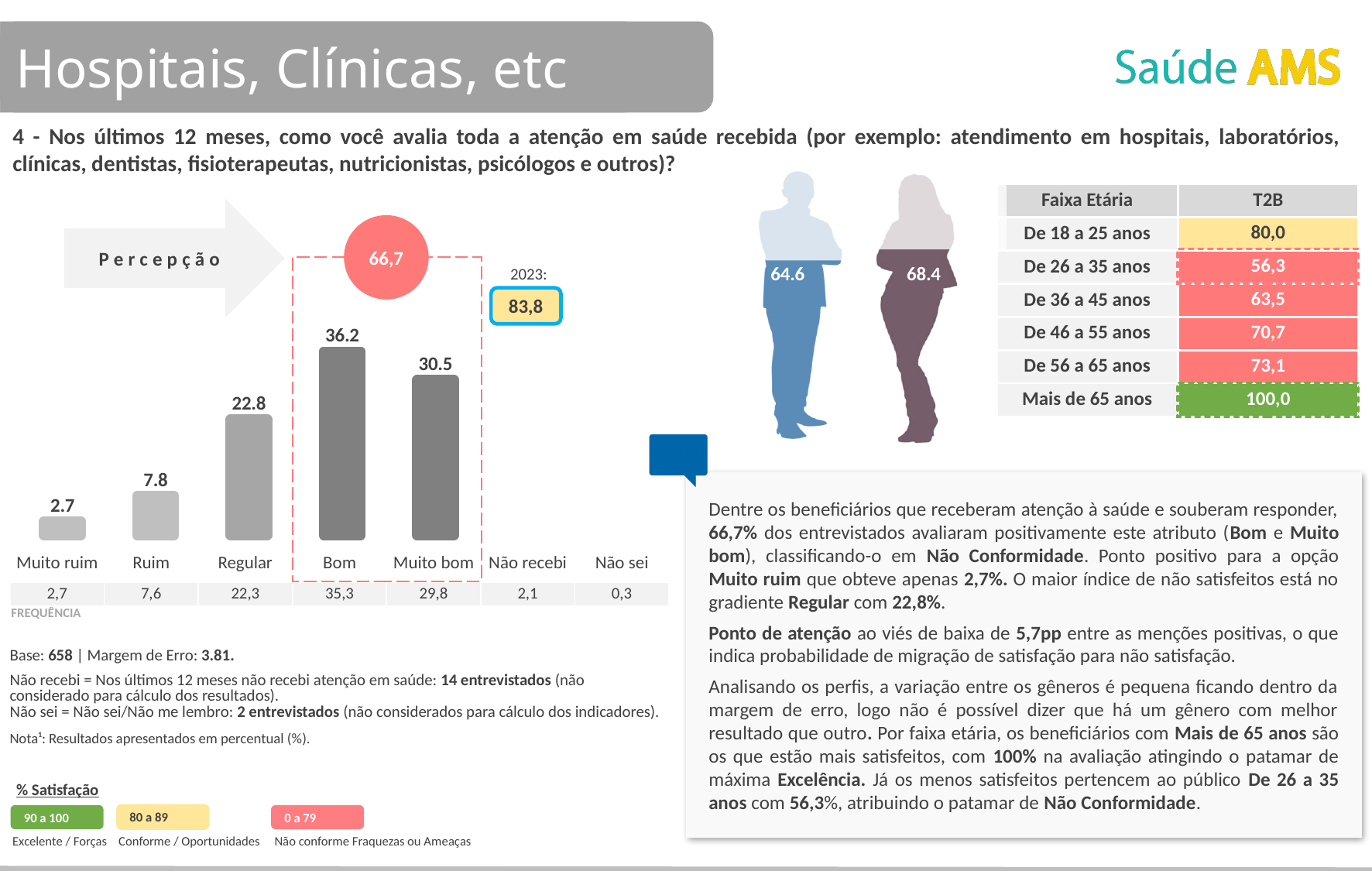
What type of chart is used to show the evaluation categories (Muito ruim to Muito bom)? bar chart What value is shown in the red circle above the Bom and Muito bom bars? 66,7 What is the value shown for the Muito ruim bar in the bar chart? 2.7 Which category has the highest bar in the bar chart? Bom Which bar is taller in the bar chart, Ruim or Regular? Regular Which category has the lowest bar in the bar chart? Muito ruim What is the value shown for the Bom bar in the bar chart? 36.2 How many bars are plotted in the bar chart? 5 What is the value shown for the Regular bar in the bar chart? 22.8 What is the difference between the Bom and Muito bom bar values in the bar chart? 5.7 What value is shown in the yellow box labelled 2023 next to the bar chart? 83,8 What is the difference between the Regular and Ruim bar values in the bar chart? 15.0